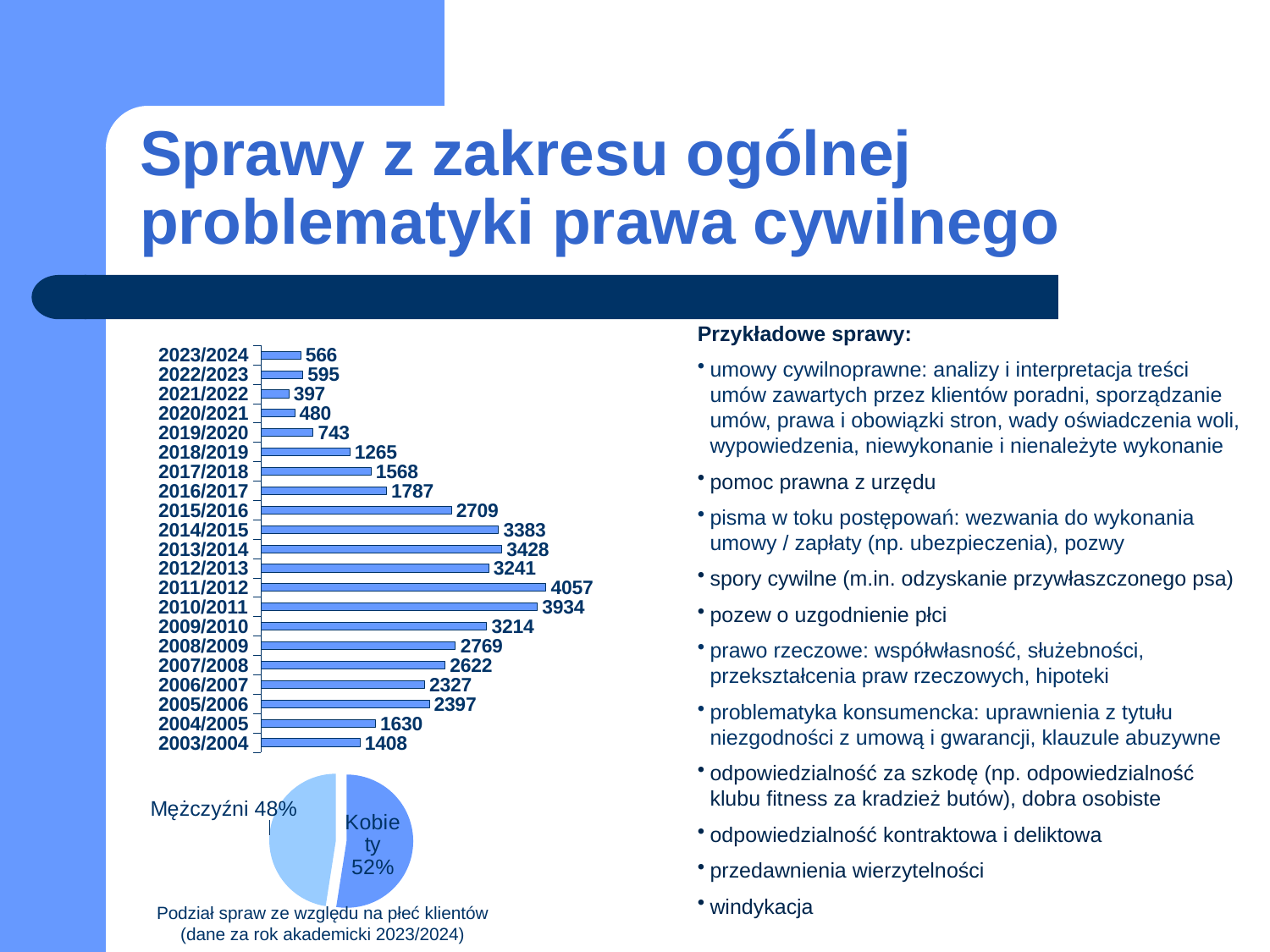
In the pie chart at the bottom left of the slide, what share is labelled Mężczyźni? 48% How many academic years are shown in the bar chart on the left of the slide? 21 What kind of chart is the upper chart on the left of the slide? bar chart What is the caption of the pie chart at the bottom left of the slide? Podział spraw ze względu na płeć klientów (dane za rok akademicki 2023/2024) In the bar chart on the left of the slide, what is the value for 2023/2024? 566 In the bar chart on the left of the slide, which academic year has the highest value? 2011/2012 In the pie chart at the bottom left of the slide, what share is labelled Kobiety? 52% In the bar chart on the left of the slide, what is the value for 2003/2004? 1408 In the bar chart on the left of the slide, what is the difference between the values for 2013/2014 and 2014/2015? 45 In the bar chart on the left of the slide, which academic year has the lowest value? 2021/2022 In the bar chart on the left of the slide, which is larger: the value for 2010/2011 or the value for 2012/2013? 2010/2011 In the bar chart on the left of the slide, what is the value for 2011/2012? 4057